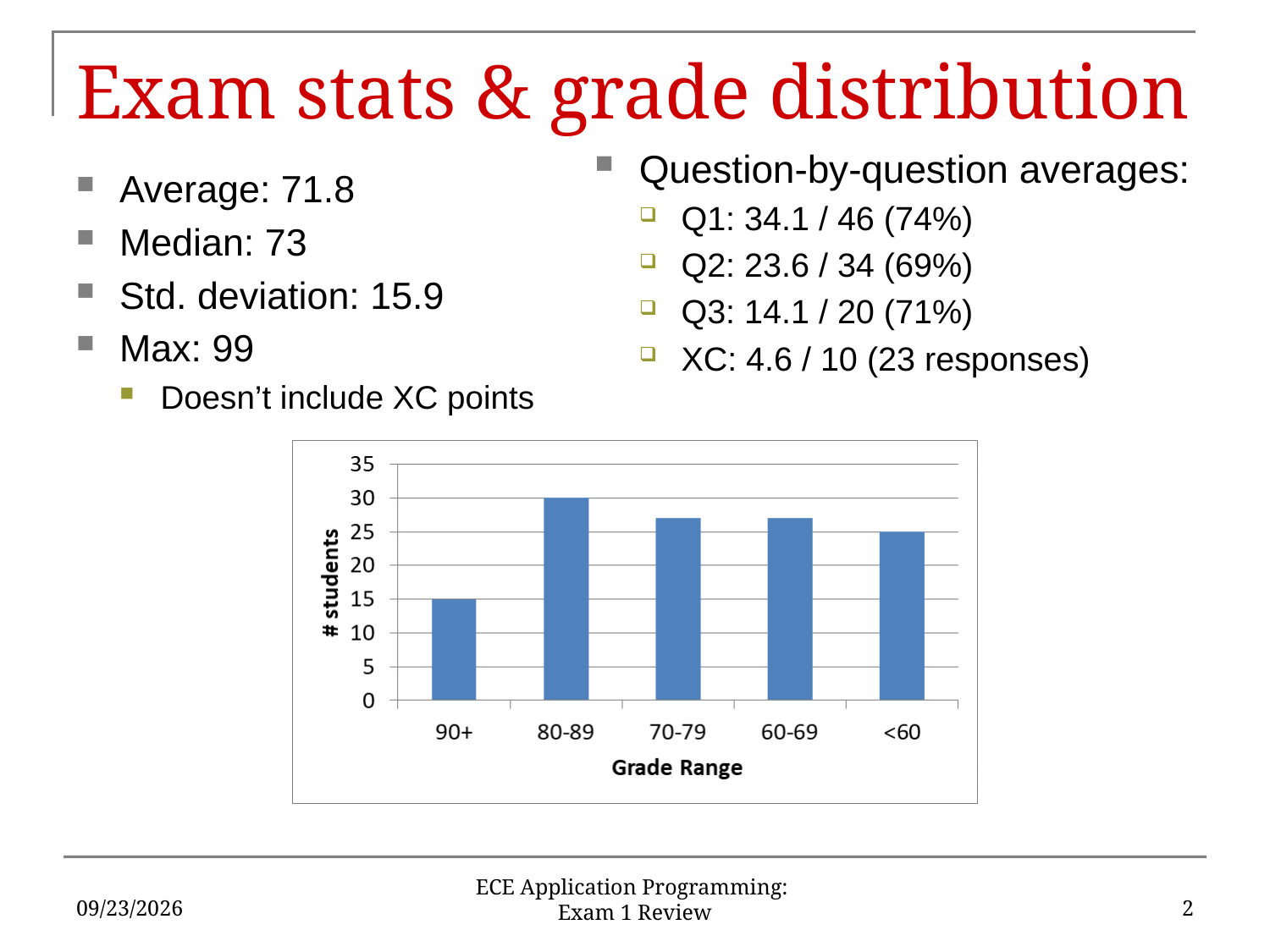
What is the label on the y axis of the chart? # students Is the number of students in the 70-79 grade range greater or less than 25? greater How many students are in the <60 grade range? 25 How many grade range categories are shown on the x axis of the chart? 5 Which grade range has the highest number of students? 80-89 How many students are in the 80-89 grade range? 30 How many students are in the 90+ grade range? 15 Which grade range has the lowest number of students? 90+ Which has more students, the 90+ grade range or the <60 grade range? <60 What is the difference in number of students between the 80-89 and 90+ grade ranges? 15 What kind of chart is shown on the slide? bar chart Is the number of students in the 60-69 grade range greater or less than 30? less